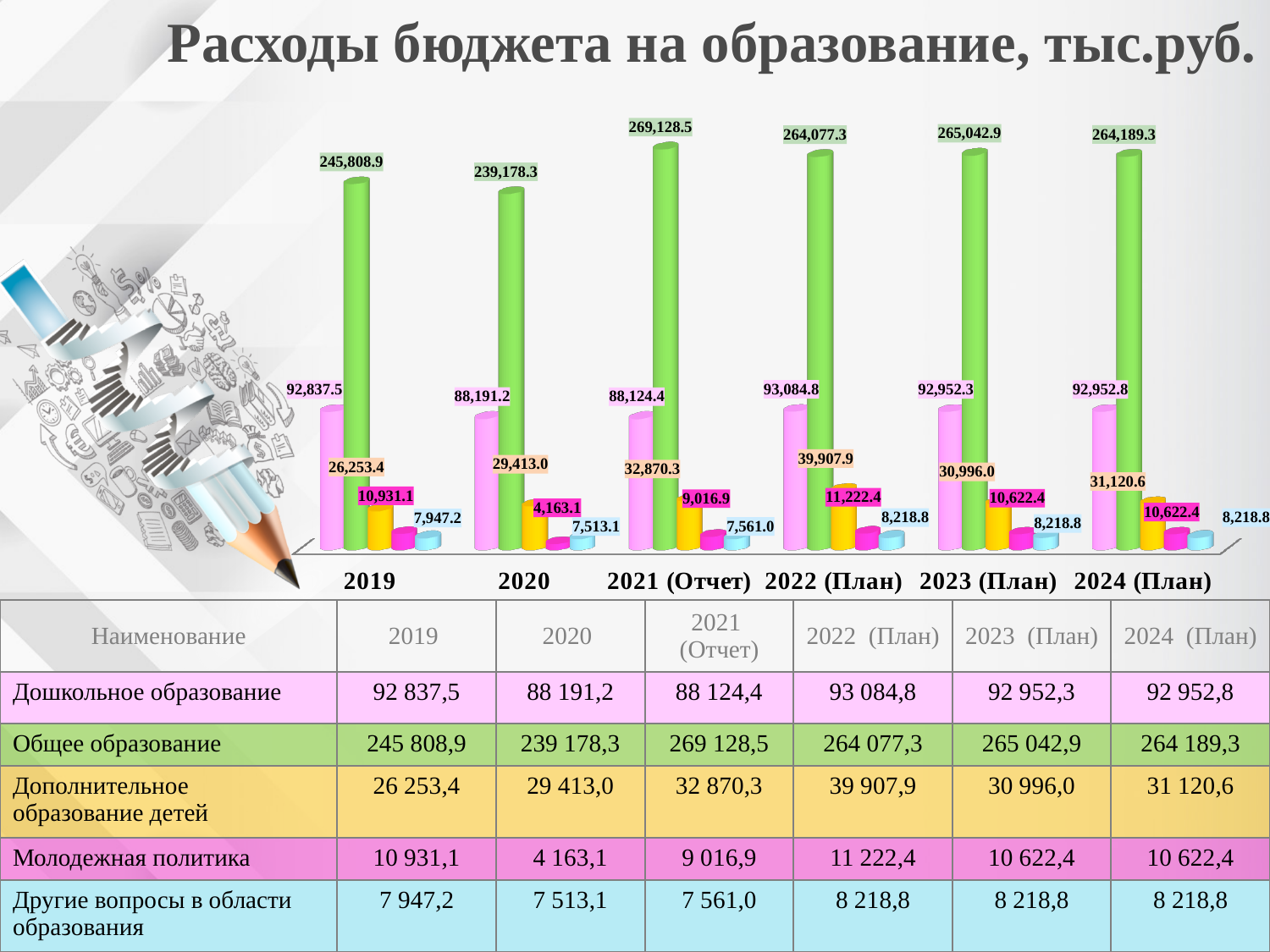
In which year does the green bar (Общее образование) reach its highest value? 2021 (Отчет) What is the difference between the green bar values for 2021 (Отчет) and 2020? 29,950.2 What is the title of the slide's chart? Расходы бюджета на образование, тыс.руб. What is the value of the green bar (Общее образование) for 2021 (Отчет)? 269,128.5 How many data series (bar colours) are plotted for each year? 5 What is the value of the yellow bar (Дополнительное образование детей) for 2022 (План)? 39,907.9 In which year is the magenta bar (Молодежная политика) lowest? 2020 What is the value of the pink bar (Дошкольное образование) for 2019? 92,837.5 What type of chart is shown on the slide? Bar chart How many year categories are shown on the x axis of the chart? 6 What is the value of the magenta bar (Молодежная политика) for 2020? 4,163.1 Which is larger: the yellow bar for 2022 (План) or the yellow bar for 2023 (План)? 2022 (План)